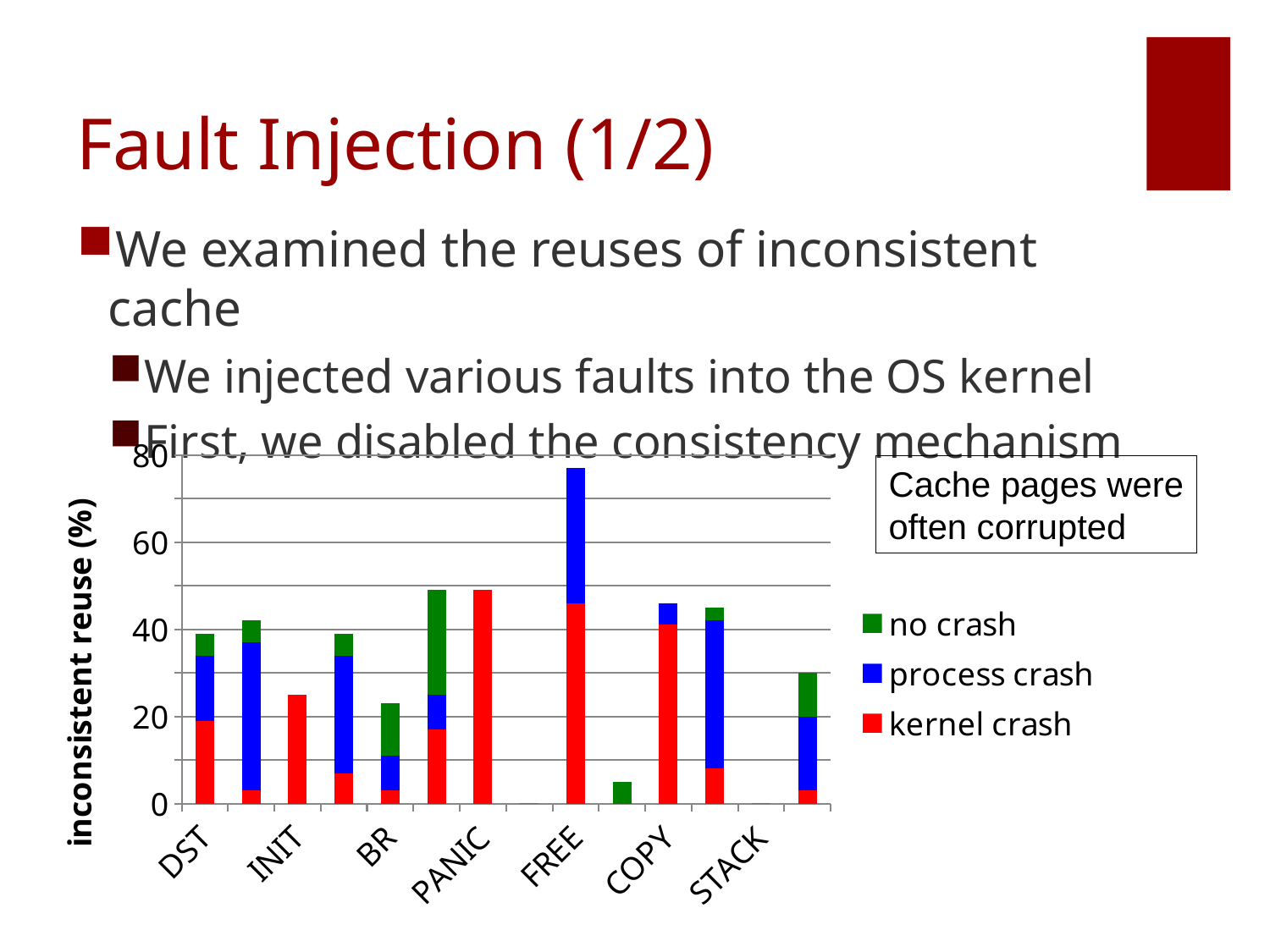
Is the total value of the bar at INIT greater or less than 40? less What kind of chart is shown on the slide? stacked bar chart How many series does the chart legend list? 3 Is the total value of the bar at FREE greater or less than 60? greater What is the label of the chart's vertical axis? inconsistent reuse (%) What are the three series named in the chart legend? no crash, process crash, kernel crash Is the total of the tallest bar in the chart greater or less than 70? greater What is the highest value shown on the chart's vertical axis? 80 Which x-axis category has the tallest stacked bar? FREE How many category labels are shown along the x axis of the chart? 7